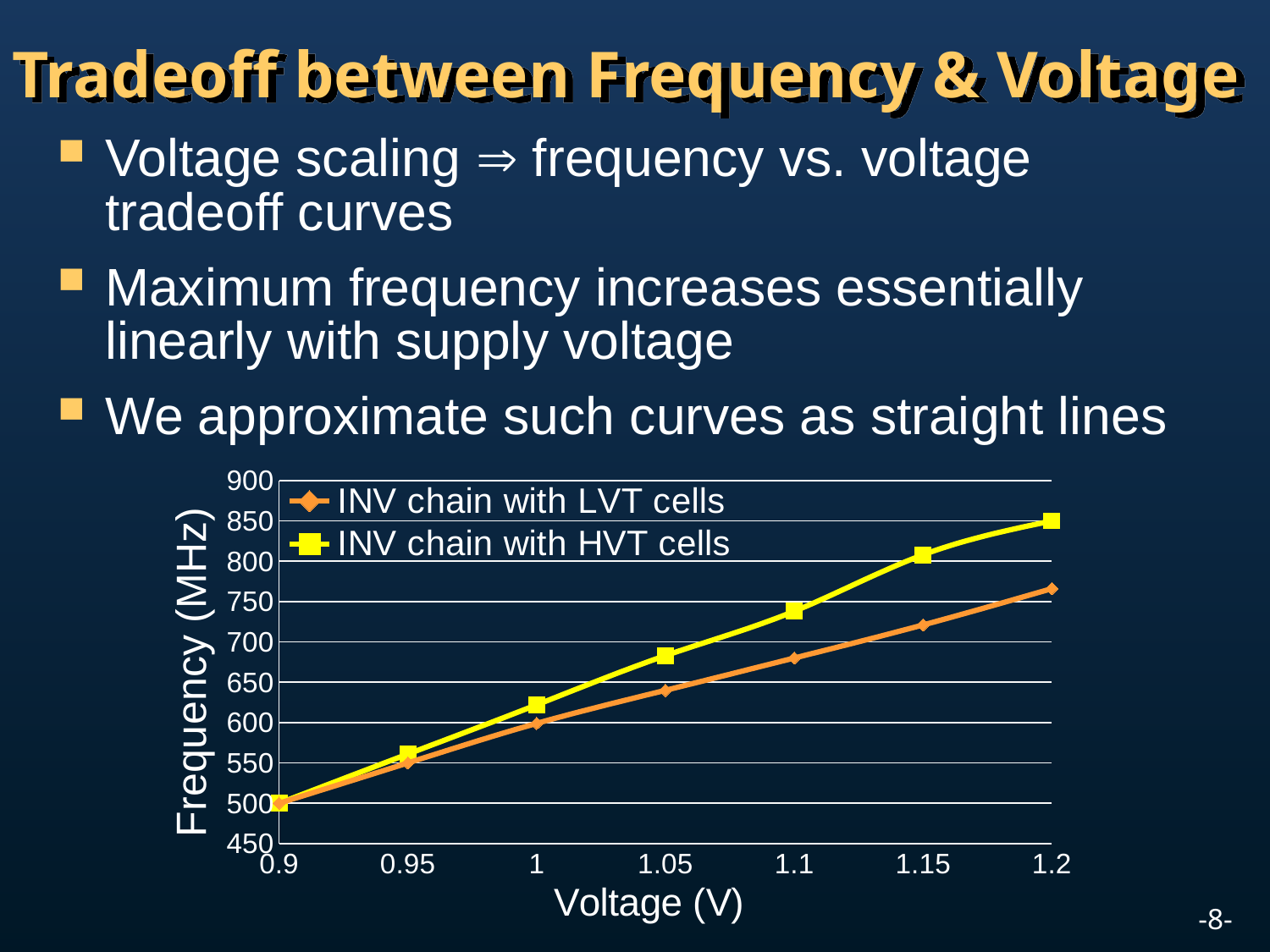
Is the frequency of the INV chain with HVT cells at 1.05 V greater or less than 650? greater How many series does the chart legend list? 2 Is the frequency of the INV chain with LVT cells at 1.1 V greater or less than 700? less Does the frequency of the INV chain with HVT cells rise or fall as voltage increases from 0.9 V to 1.2 V? rise Is the frequency of the INV chain with HVT cells at 1.1 V greater or less than 700? greater At 1.2 V, which series has the higher frequency: INV chain with LVT cells or INV chain with HVT cells? INV chain with HVT cells How many voltage points are plotted for each series in the chart? 7 Which series reaches the highest frequency on the chart? INV chain with HVT cells What is the label of the chart's x axis? Voltage (V) What kind of chart is shown on the slide? line chart What is the label of the chart's y axis? Frequency (MHz)